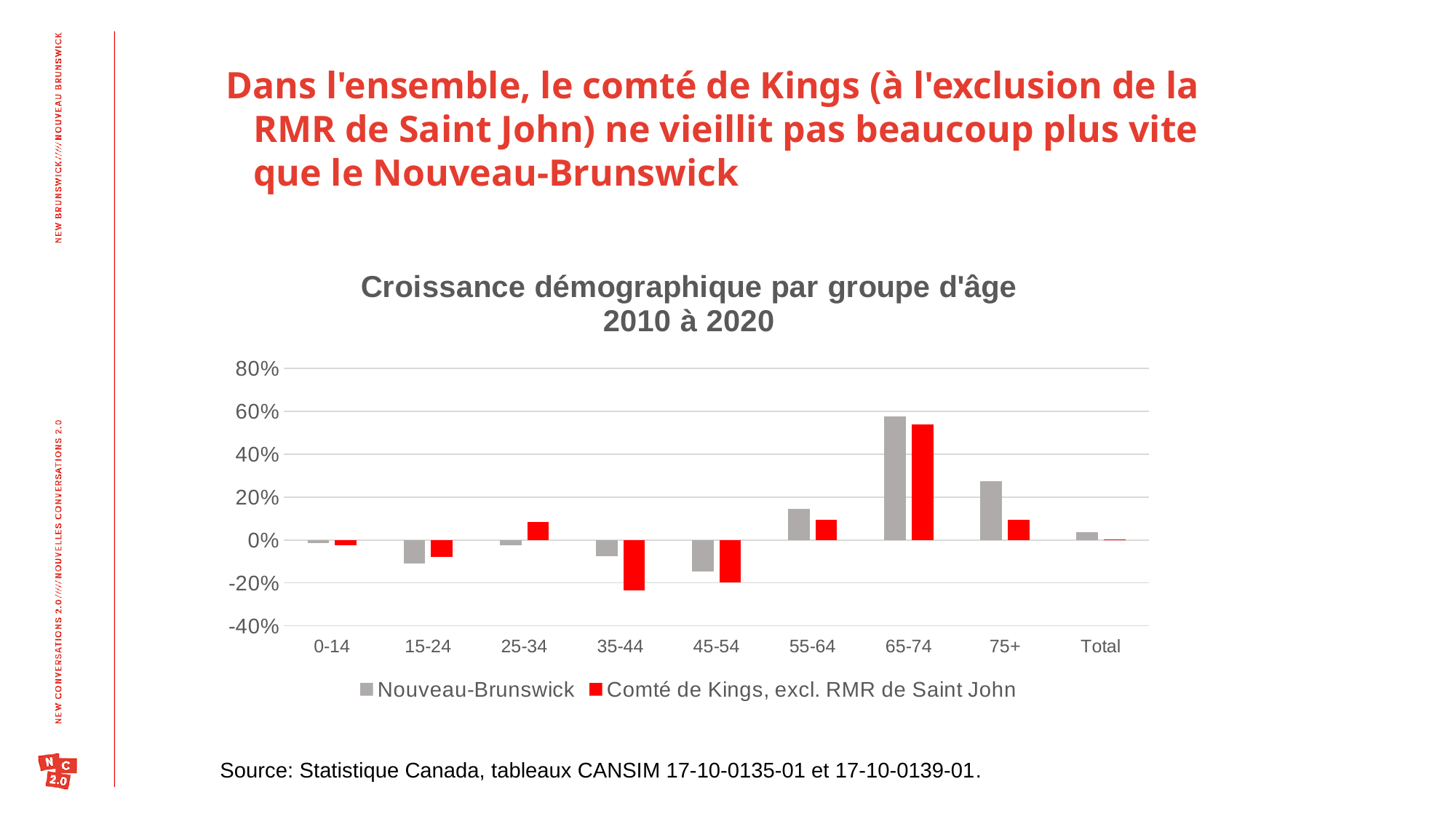
How many categories are shown along the x axis? 9 For the 75+ group, which series has the larger value, Nouveau-Brunswick or Comté de Kings, excl. RMR de Saint John? Nouveau-Brunswick For the 25-34 group, which series has the larger value, Nouveau-Brunswick or Comté de Kings, excl. RMR de Saint John? Comté de Kings, excl. RMR de Saint John What is the title of the chart? Croissance démographique par groupe d'âge 2010 à 2020 Which age group has the lowest value for Nouveau-Brunswick? 45-54 Which age group has the highest value for Nouveau-Brunswick? 65-74 Is the value for Comté de Kings, excl. RMR de Saint John in the 35-44 group greater or less than -20%? less Which age group has the lowest value for Comté de Kings, excl. RMR de Saint John? 35-44 How many series does the legend list? 2 Is the value for Nouveau-Brunswick in the 65-74 group greater or less than 40%? greater Which age group has the highest value for Comté de Kings, excl. RMR de Saint John? 65-74 What kind of chart is shown on the slide? bar chart